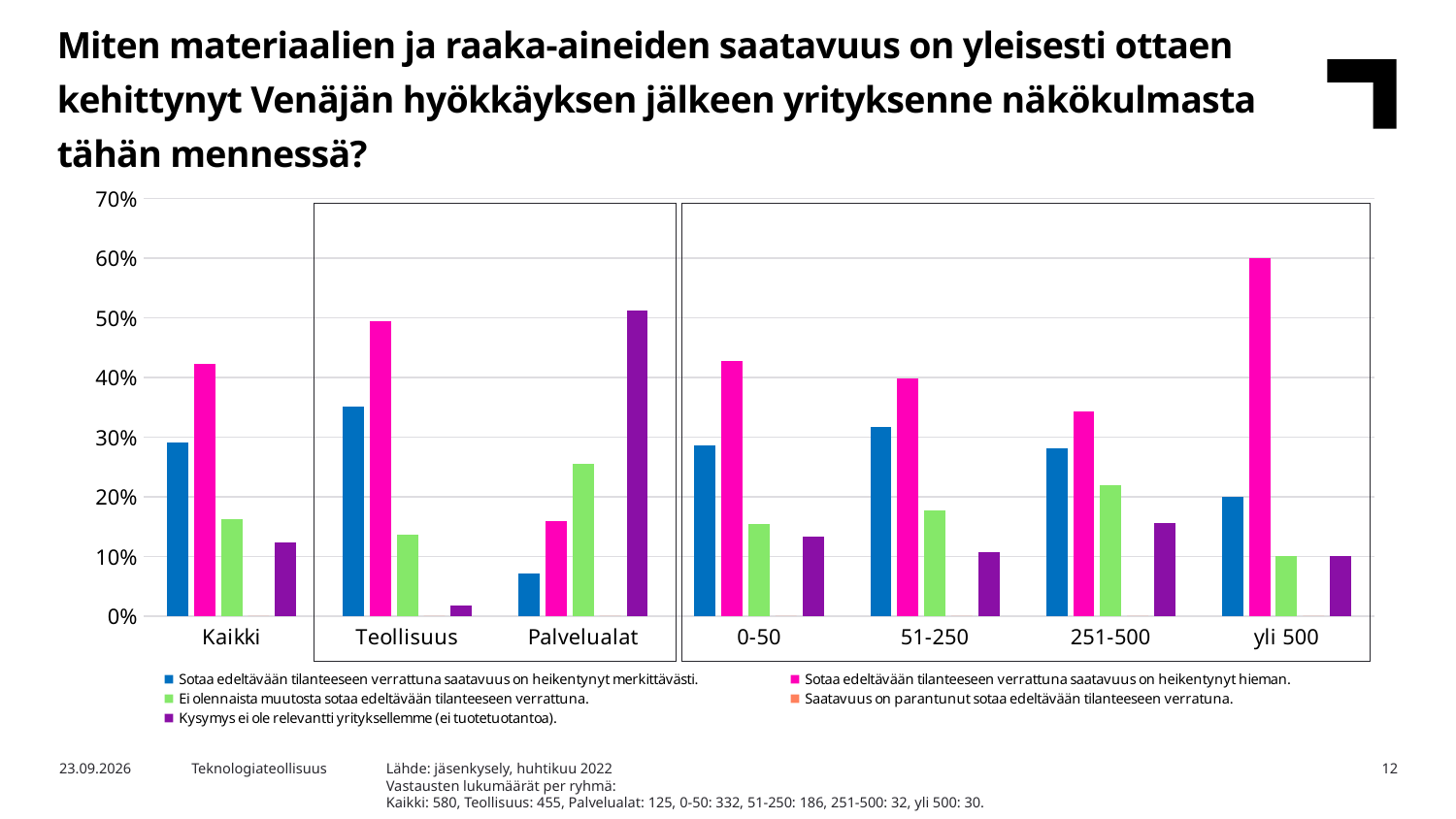
What kind of chart is shown on the slide? bar chart Which category has the highest bar for 'Sotaa edeltävään tilanteeseen verrattuna saatavuus on heikentynyt hieman'? yli 500 What colour represents 'Kysymys ei ole relevantti yrityksellemme (ei tuotetuotantoa)' in the chart? purple Is the value for 'Ei olennaista muutosta sotaa edeltävään tilanteeseen verrattuna' in the Palvelualat category greater or less than 20%? greater Which category has the larger value for 'saatavuus on heikentynyt merkittävästi': Teollisuus or Palvelualat? Teollisuus Is the value for 'saatavuus on heikentynyt merkittävästi' in the Kaikki category greater or less than 20%? greater How many series does the chart's legend list? 5 In the Kaikki category, which is larger: 'heikentynyt hieman' or 'Ei olennaista muutosta'? heikentynyt hieman Is the value for 'heikentynyt hieman' in the yli 500 category greater or less than 50%? greater Which category has the lowest bar for 'Kysymys ei ole relevantti yrityksellemme (ei tuotetuotantoa)'? Teollisuus How many categories are shown along the x axis of the chart? 7